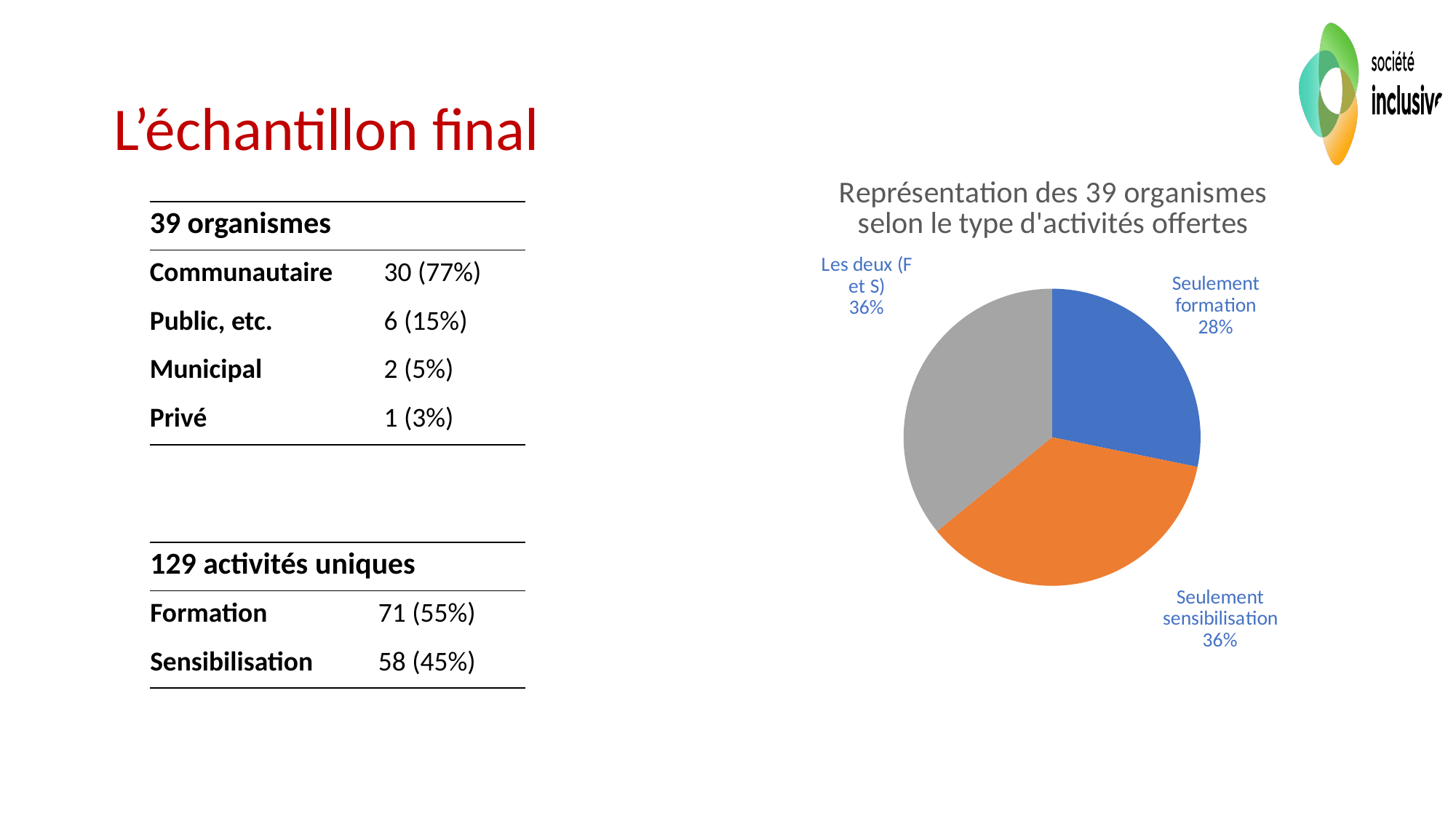
What share of the pie does "Les deux (F et S)" represent? 36% Which category has the smallest slice of the pie? Seulement formation What share of the pie does "Seulement formation" represent? 28% What is the difference in percentage points between the "Les deux (F et S)" slice and the "Seulement formation" slice? 8 percentage points What colour is the "Seulement sensibilisation" slice? Orange What share of the pie does "Seulement sensibilisation" represent? 36% Is the share for "Seulement formation" greater or less than 30%? less What is the title of the pie chart? Représentation des 39 organismes selon le type d'activités offertes Which is larger: the slice for "Seulement formation" or the slice for "Seulement sensibilisation"? Seulement sensibilisation How many slices does the pie chart have? 3 What kind of chart is shown on the slide? Pie chart